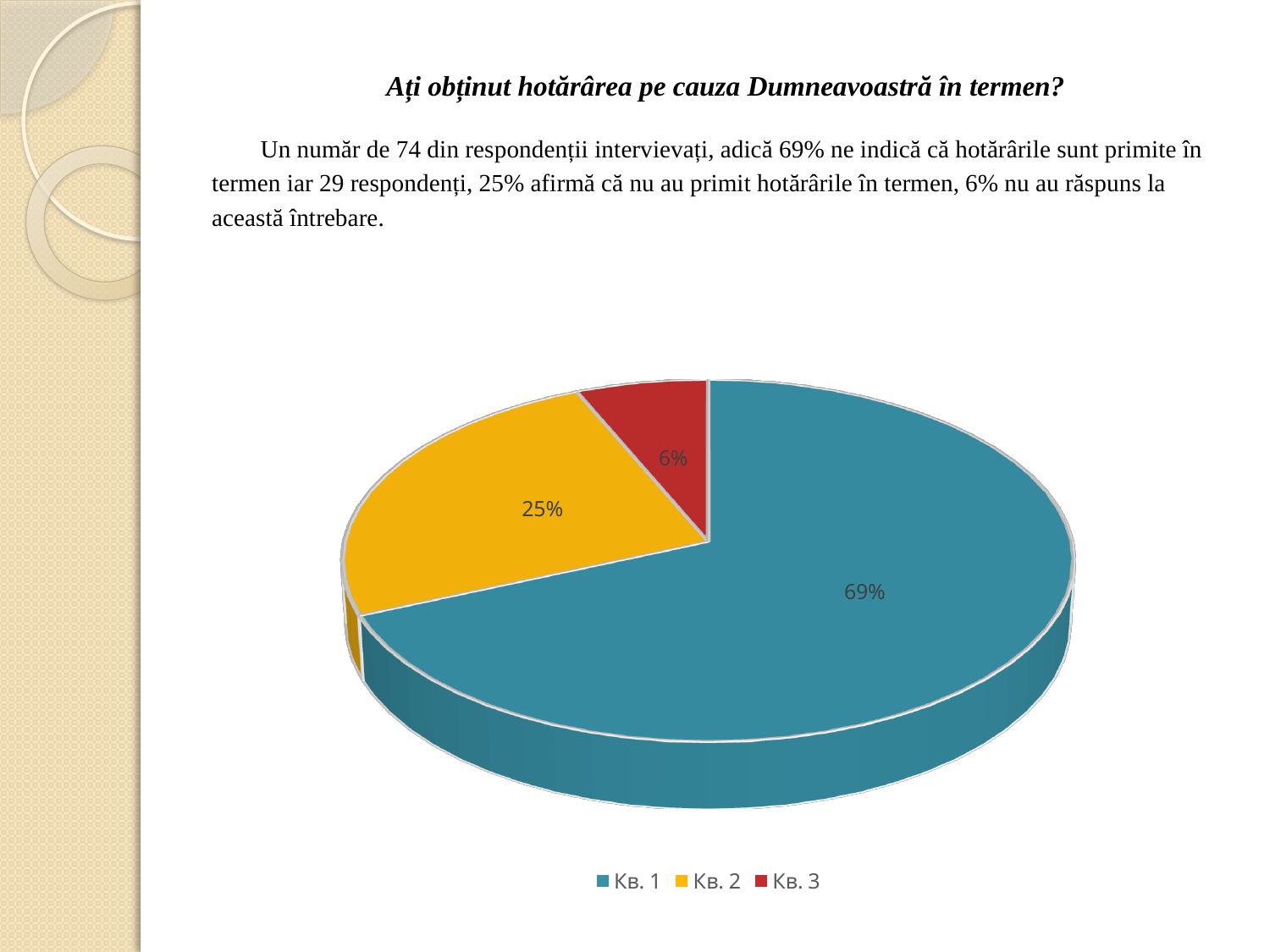
What is the difference between the Кв. 1 and Кв. 2 slices? 44% What kind of chart is shown on the slide? pie chart Which slice of the pie chart is the largest? Кв. 1 What is the value for Кв. 3 in the pie chart? 6% How many entries does the legend list? 3 Which is larger, the Кв. 2 slice or the Кв. 3 slice? Кв. 2 What is the value for Кв. 1 in the pie chart? 69% What is the value for Кв. 2 in the pie chart? 25% Which slice of the pie chart is the smallest? Кв. 3 How many slices does the pie chart have? 3 What colour is the Кв. 2 slice in the pie chart? yellow What is the difference between the Кв. 2 and Кв. 3 slices? 19%